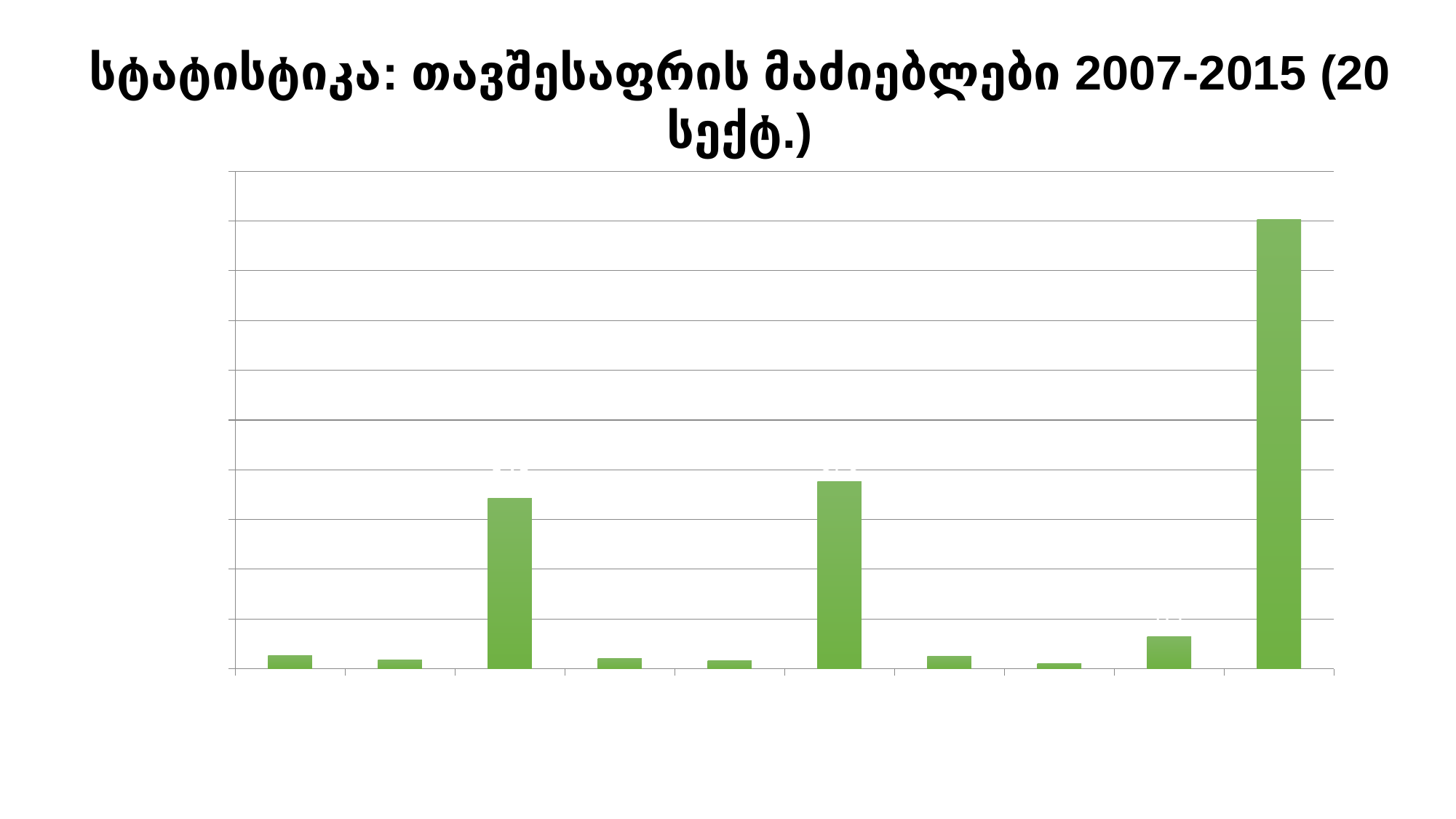
Which bar is the tallest in the chart, counting from the left? the 10th (rightmost) bar What colour are the bars in the chart? green Which is taller: the third bar from the left or the sixth bar from the left? the sixth bar What kind of chart is shown on the slide? bar chart Which is taller: the rightmost bar or the third bar from the left? the rightmost bar What year range is given in the chart's title? 2007-2015 Which is taller: the ninth bar from the left or the first bar from the left? the ninth bar How many bars are plotted in the chart? 10